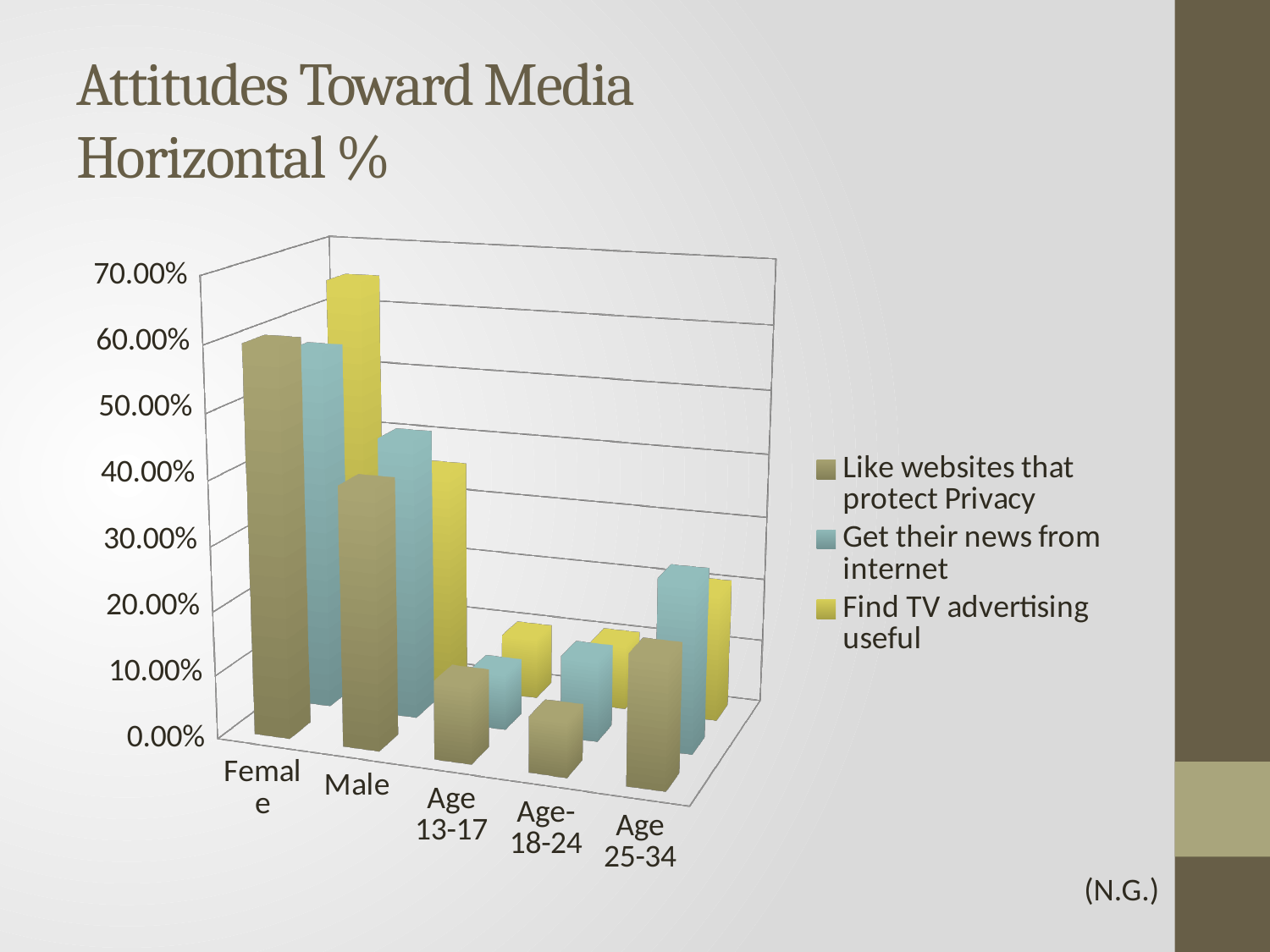
For "Like websites that protect Privacy", which is larger: Female or Age 13-17? Female Is the value for Age-18-24 in the "Like websites that protect Privacy" series greater or less than 10.00%? less How many series does the chart's legend list? 3 Which category has the lowest value for "Like websites that protect Privacy"? Age-18-24 What is the title of the slide containing the chart? Attitudes Toward Media Horizontal % Is the value for Female in the "Like websites that protect Privacy" series greater or less than 50.00%? greater For "Get their news from internet", which is larger: Male or Age 25-34? Male Which category has the highest value for "Get their news from internet"? Female Is the value for Age 13-17 in the "Find TV advertising useful" series greater or less than 30.00%? less How many categories are shown along the x axis of the chart? 5 Which category has the highest value for "Find TV advertising useful"? Female What kind of chart is shown on the slide? bar chart